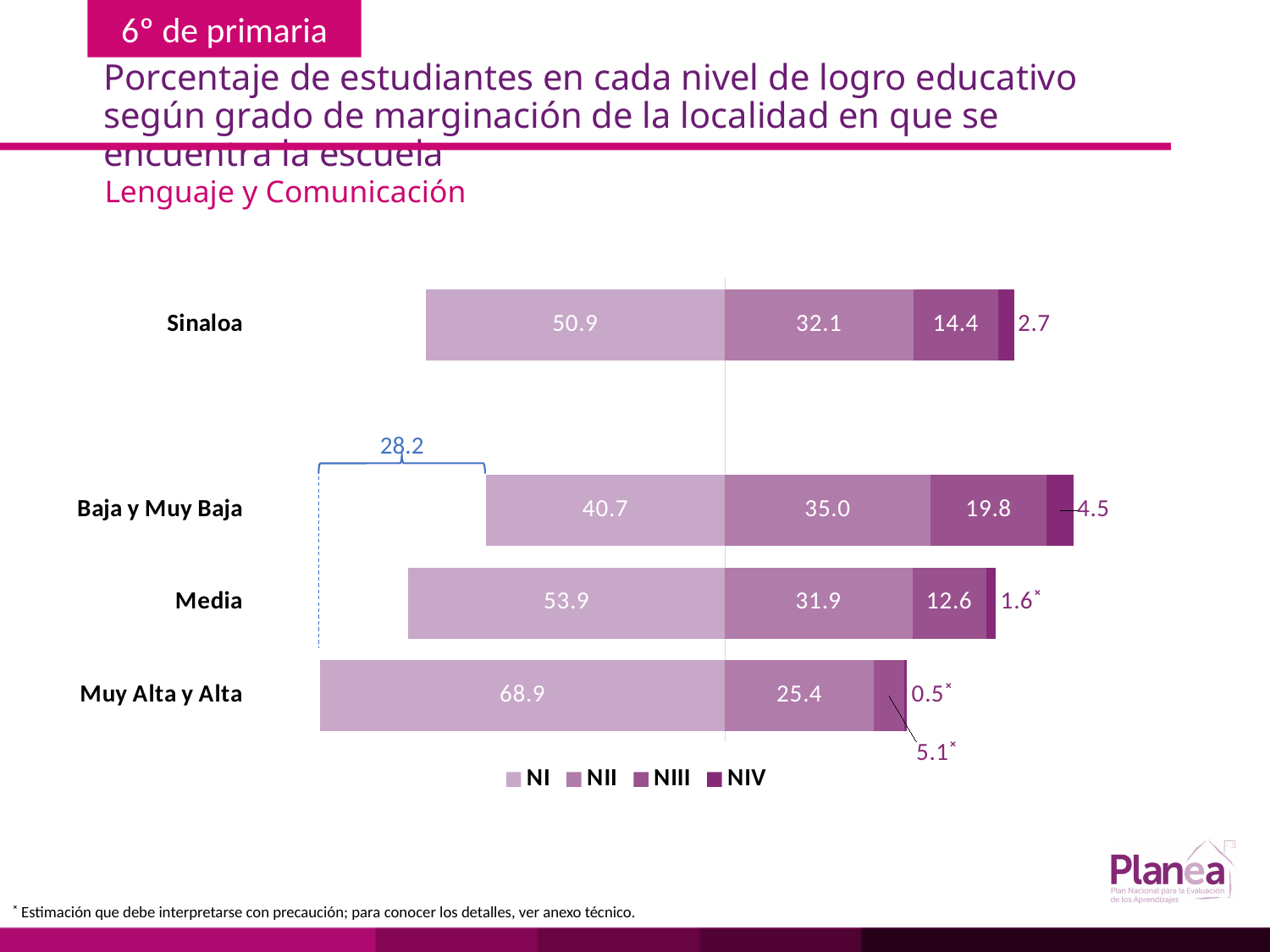
How many categories (bars) are shown in the chart? 4 What kind of chart is shown on the slide? Stacked bar chart How many series does the legend list? 4 Which category has the highest NIV value? Baja y Muy Baja Which category has the lowest NI value? Baja y Muy Baja What is the NI value for Sinaloa? 50.9 What is the NIV value for Sinaloa? 2.7 Which category has the highest NI value? Muy Alta y Alta Which is larger, the NIII value for Baja y Muy Baja or the NIII value for Sinaloa? Baja y Muy Baja What is the NIII value for Media? 12.6 What is the NII value for Baja y Muy Baja? 35.0 What is the difference between the NI value for Muy Alta y Alta and the NI value for Baja y Muy Baja? 28.2